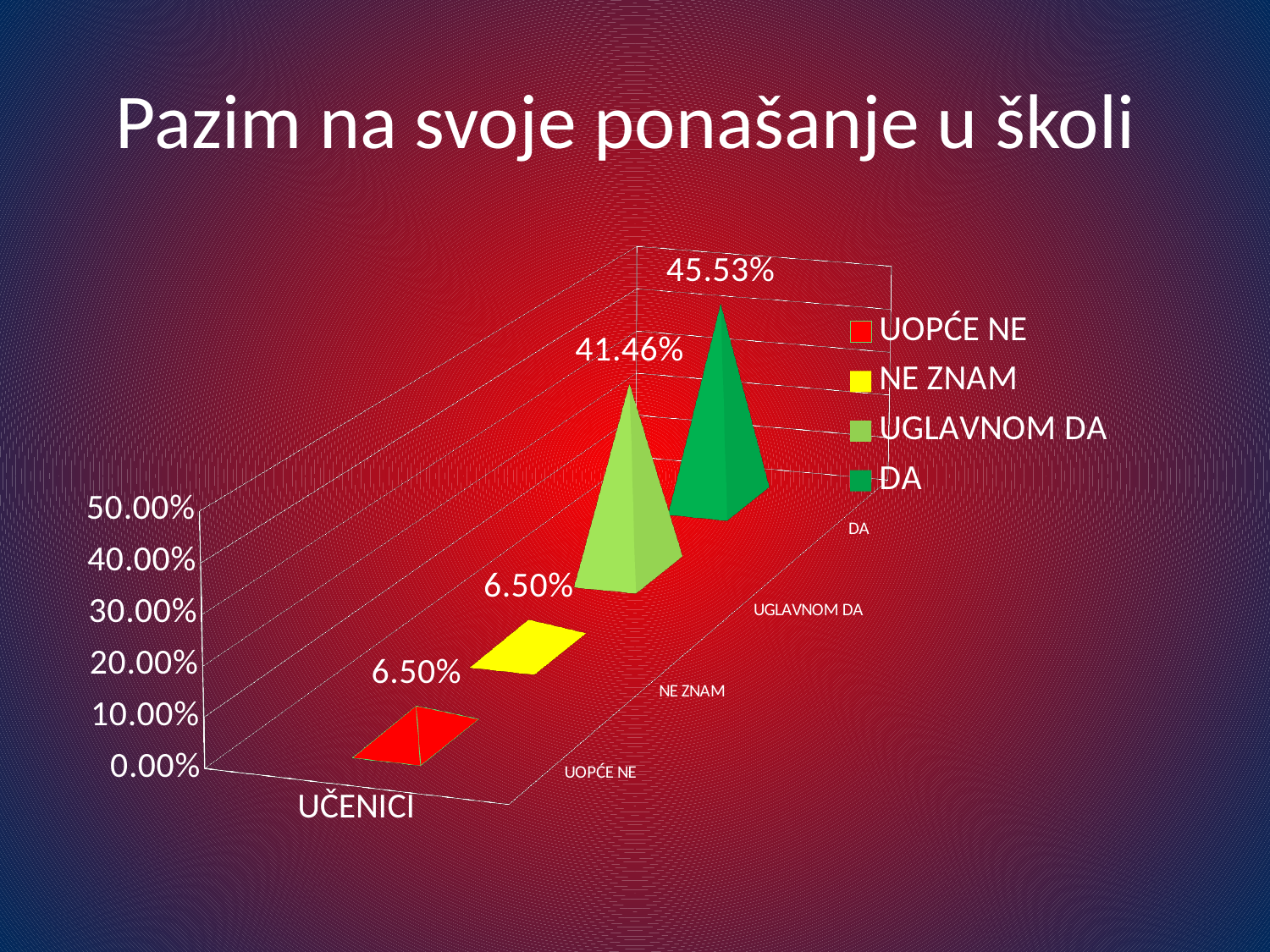
Which response has the highest value? DA What is the title of the chart? Pazim na svoje ponašanje u školi What is the label of the category on the x axis? UČENICI Is the value for UGLAVNOM DA greater or less than 40.00%? greater What is the difference between the values for UGLAVNOM DA and NE ZNAM? 34.96% What is the value for UGLAVNOM DA? 41.46% What is the value for DA? 45.53% Which is larger, the value for DA or the value for UGLAVNOM DA? DA What is the value for NE ZNAM? 6.50% What is the value for UOPĆE NE? 6.50% How many series does the legend list? 4 What is the difference between the values for DA and UGLAVNOM DA? 4.07%